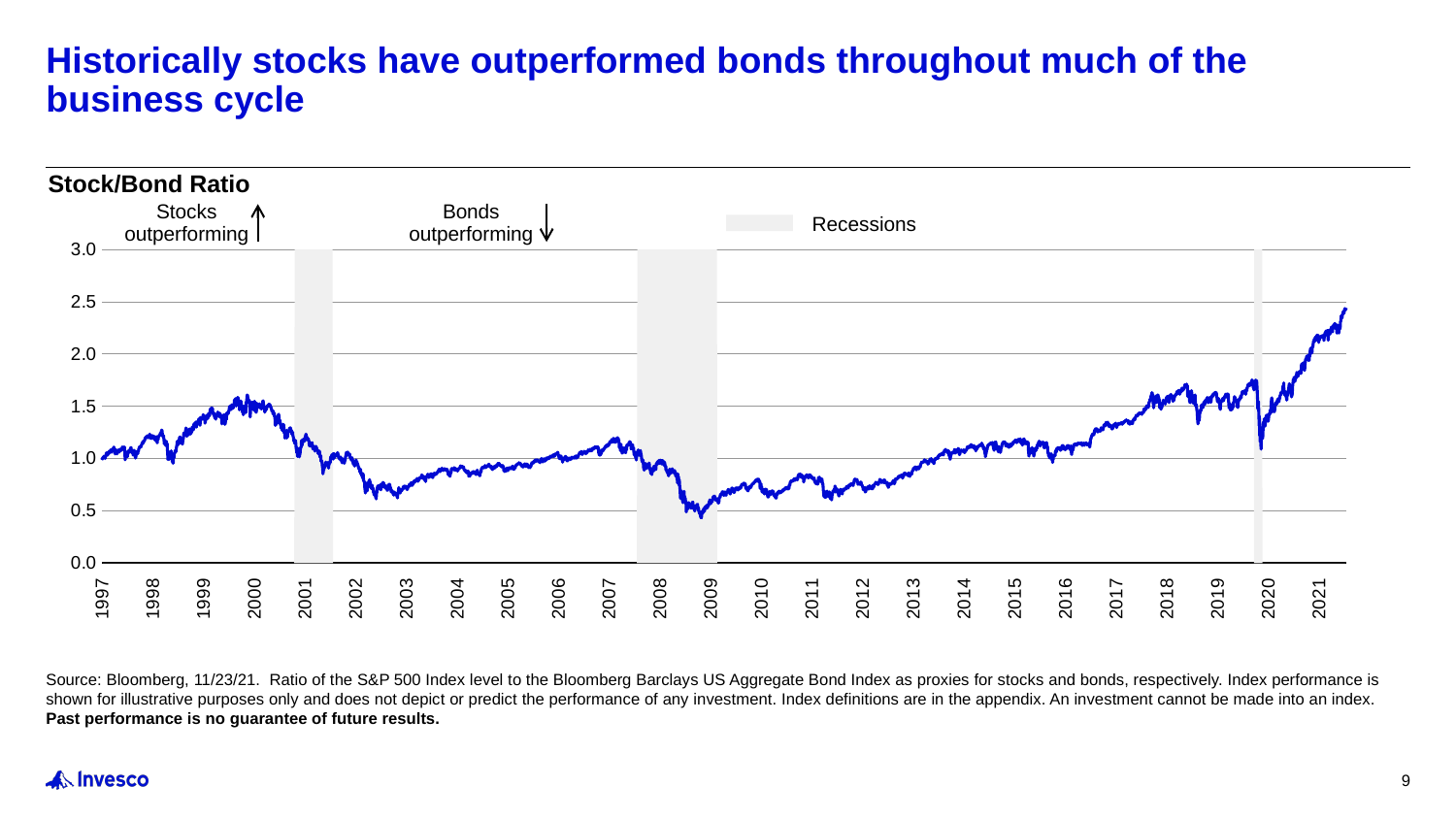
Is the Stock/Bond Ratio at the end of 2021 greater or less than 2.0? greater Is the Stock/Bond Ratio in 2021 greater or less than 1.5? greater Is the Stock/Bond Ratio in 2003 greater or less than 1.0? less Does the Stock/Bond Ratio rise or fall overall from 2009 to 2021? rise In which year does the Stock/Bond Ratio reach its highest level on the chart? 2021 What kind of chart is shown on the slide? Line chart Is the Stock/Bond Ratio higher in 2021 or in 2009? 2021 What is the title of the chart? Stock/Bond Ratio How many shaded recession periods are marked on the chart? 3 In which year does the Stock/Bond Ratio reach its lowest level on the chart? 2009